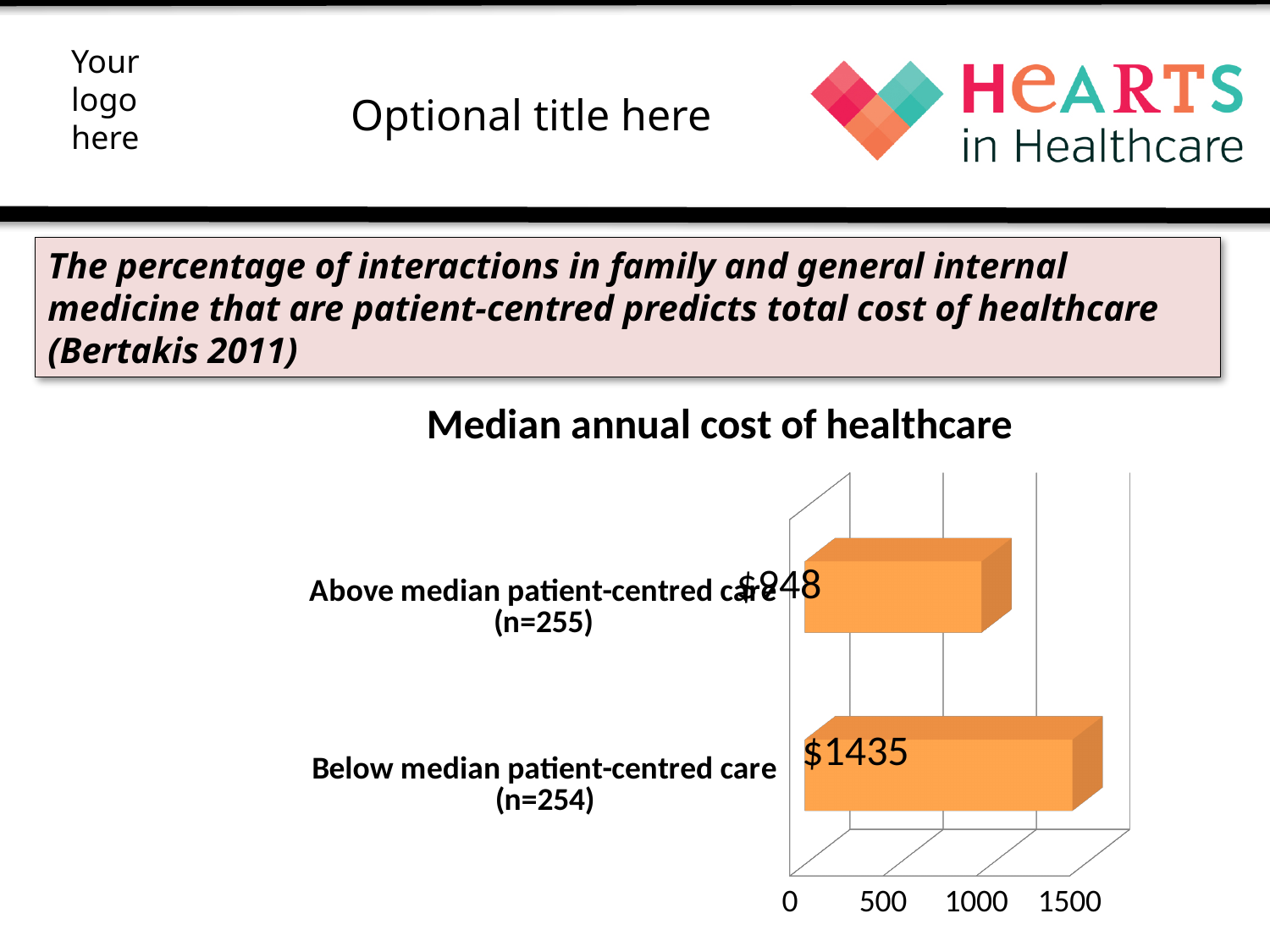
Is the value for Above median patient-centred care greater or less than 1000? less What is the median annual cost of healthcare for Below median patient-centred care (n=254)? $1435 What is the highest value shown on the x axis of the chart? 1500 What kind of chart is shown on the slide? Bar chart Which category has the lower median annual cost of healthcare? Above median patient-centred care (n=255) Is the value for Below median patient-centred care greater or less than 1000? greater What is the title of the chart? Median annual cost of healthcare How many categories are shown in the chart? 2 Which category has the higher median annual cost of healthcare? Below median patient-centred care (n=254) Is the median annual cost higher for Above median patient-centred care or Below median patient-centred care? Below median patient-centred care What is the difference in median annual cost between Below median patient-centred care and Above median patient-centred care? $487 What is the median annual cost of healthcare for Above median patient-centred care (n=255)? $948